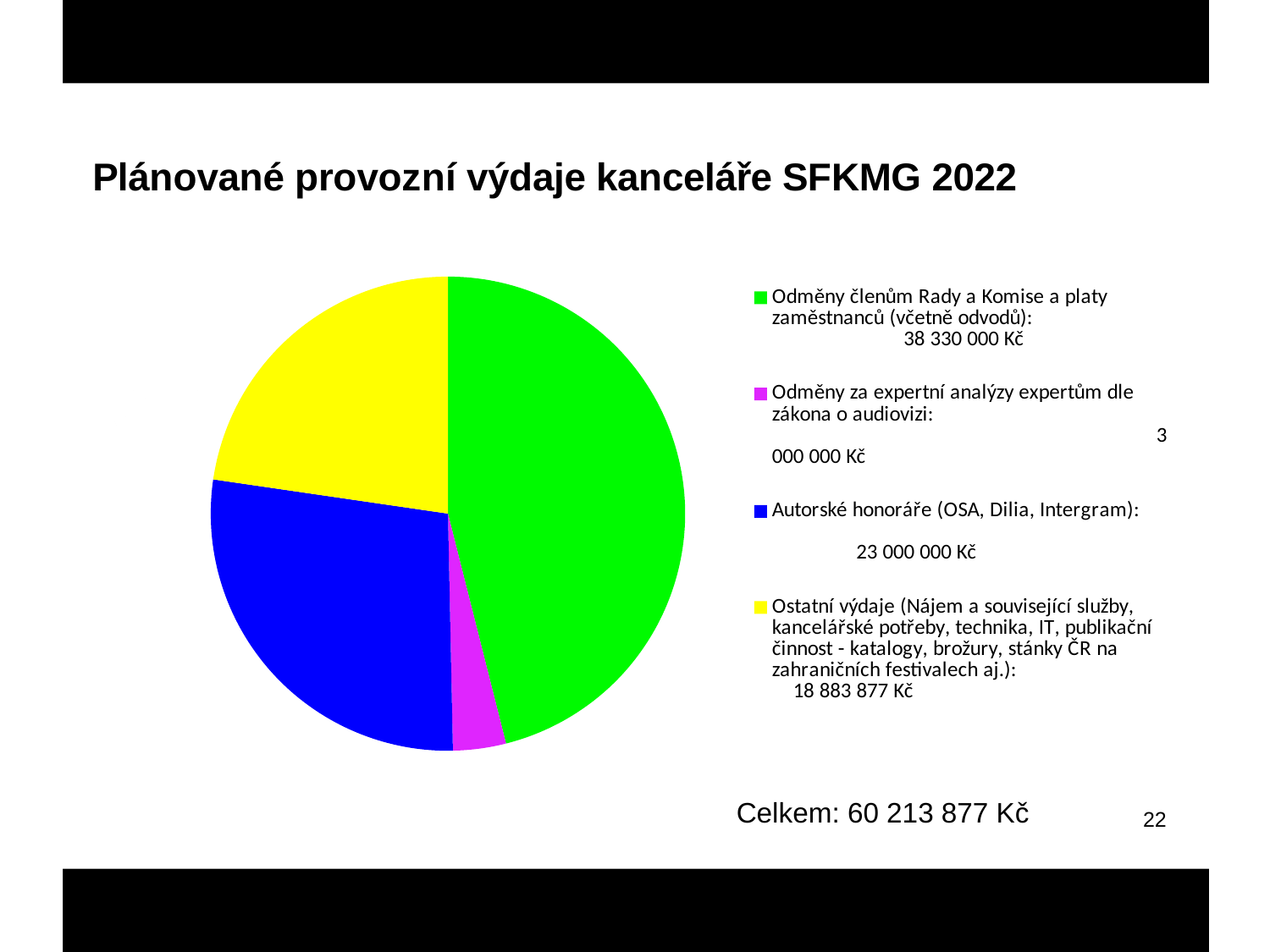
What is the value for 'Odměny za expertní analýzy expertům dle zákona o audiovizi'? 3 000 000 Kč What colour is the slice for 'Autorské honoráře (OSA, Dilia, Intergram)'? Blue What is the difference between 'Odměny členům Rady a Komise a platy zaměstnanců' and 'Autorské honoráře'? 15 330 000 Kč Which is larger: 'Autorské honoráře (OSA, Dilia, Intergram)' or 'Ostatní výdaje'? Autorské honoráře (OSA, Dilia, Intergram) What is the value for 'Odměny členům Rady a Komise a platy zaměstnanců (včetně odvodů)'? 38 330 000 Kč How many slices does the pie chart have? 4 Which category has the largest slice of the pie? Odměny členům Rady a Komise a platy zaměstnanců (včetně odvodů) What is the value for 'Autorské honoráře (OSA, Dilia, Intergram)'? 23 000 000 Kč What total amount (Celkem) is stated on the slide? 60 213 877 Kč Which category has the smallest slice of the pie? Odměny za expertní analýzy expertům dle zákona o audiovizi What kind of chart is shown on the slide? Pie chart What is the value for 'Ostatní výdaje'? 18 883 877 Kč